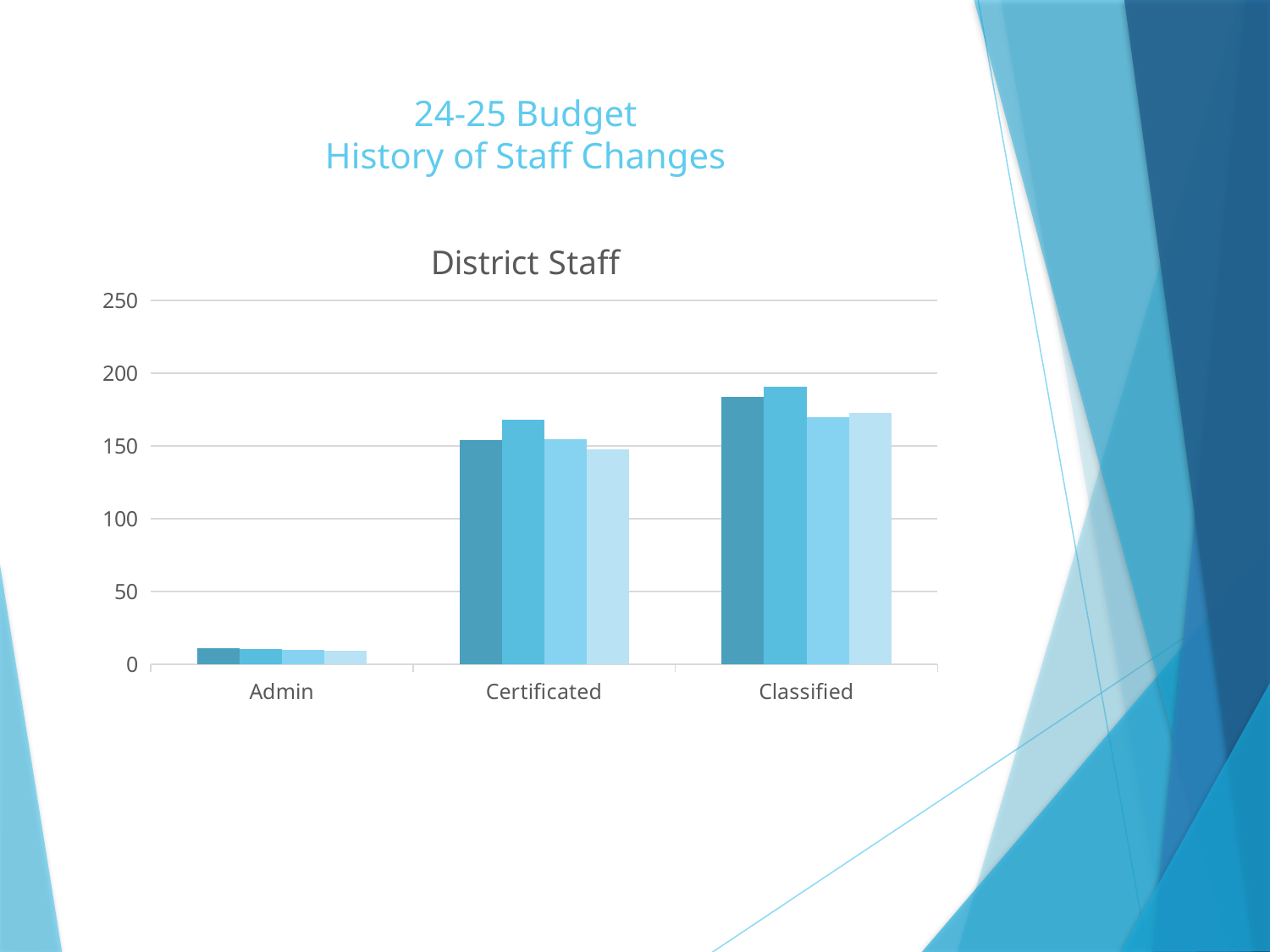
Are the values for Classified greater or less than 200? less Which category has the highest bars in the District Staff chart? Classified What type of chart is shown on the slide? bar chart Which category has larger values, Certificated or Classified? Classified Are the values for Classified greater or less than 150? greater What is the title of the chart? District Staff How many bars are plotted for each category in the District Staff chart? 4 Are the values for Admin greater or less than 50? less What is the highest value shown on the y axis of the District Staff chart? 250 Which category has the lowest bars in the District Staff chart? Admin How many categories are shown on the x axis of the District Staff chart? 3